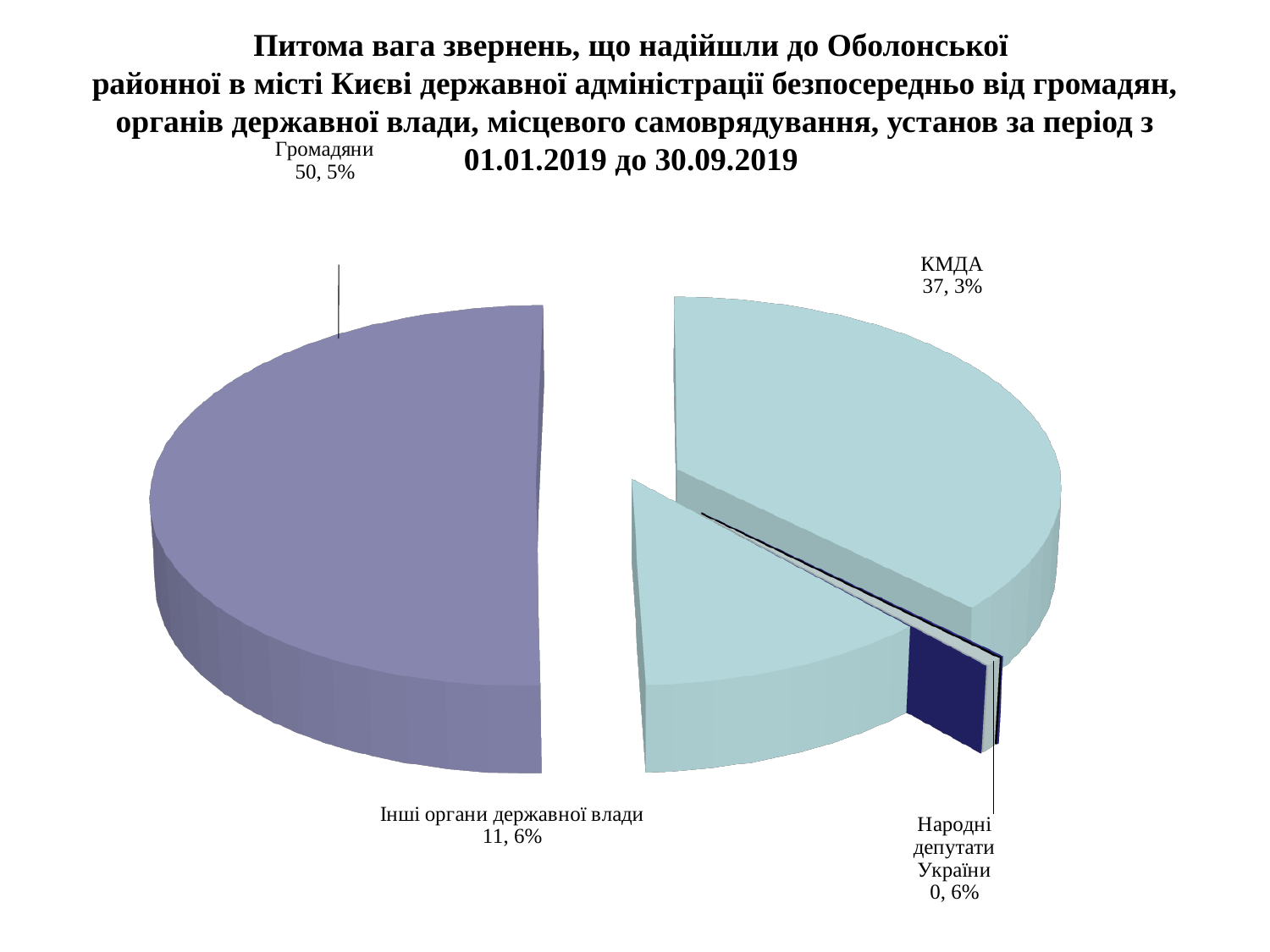
What colour is the Громадяни slice? purple Which labelled category has the smallest slice of the pie? Народні депутати України What value is shown for the Громадяни slice? 50, 5% Which slice is larger, КМДА or Інші органи державної влади? КМДА What share of the pie does the Громадяни slice represent, as labelled? 50, 5% Which category has the largest slice of the pie? Громадяни What value is shown for the Інші органи державної влади slice? 11, 6% What value is shown for the КМДА slice? 37, 3% What kind of chart is shown on the slide? pie chart Which slice is larger, Громадяни or КМДА? Громадяни What value is shown for the Народні депутати України slice? 0, 6% What period does the chart title say the data covers? 01.01.2019 до 30.09.2019